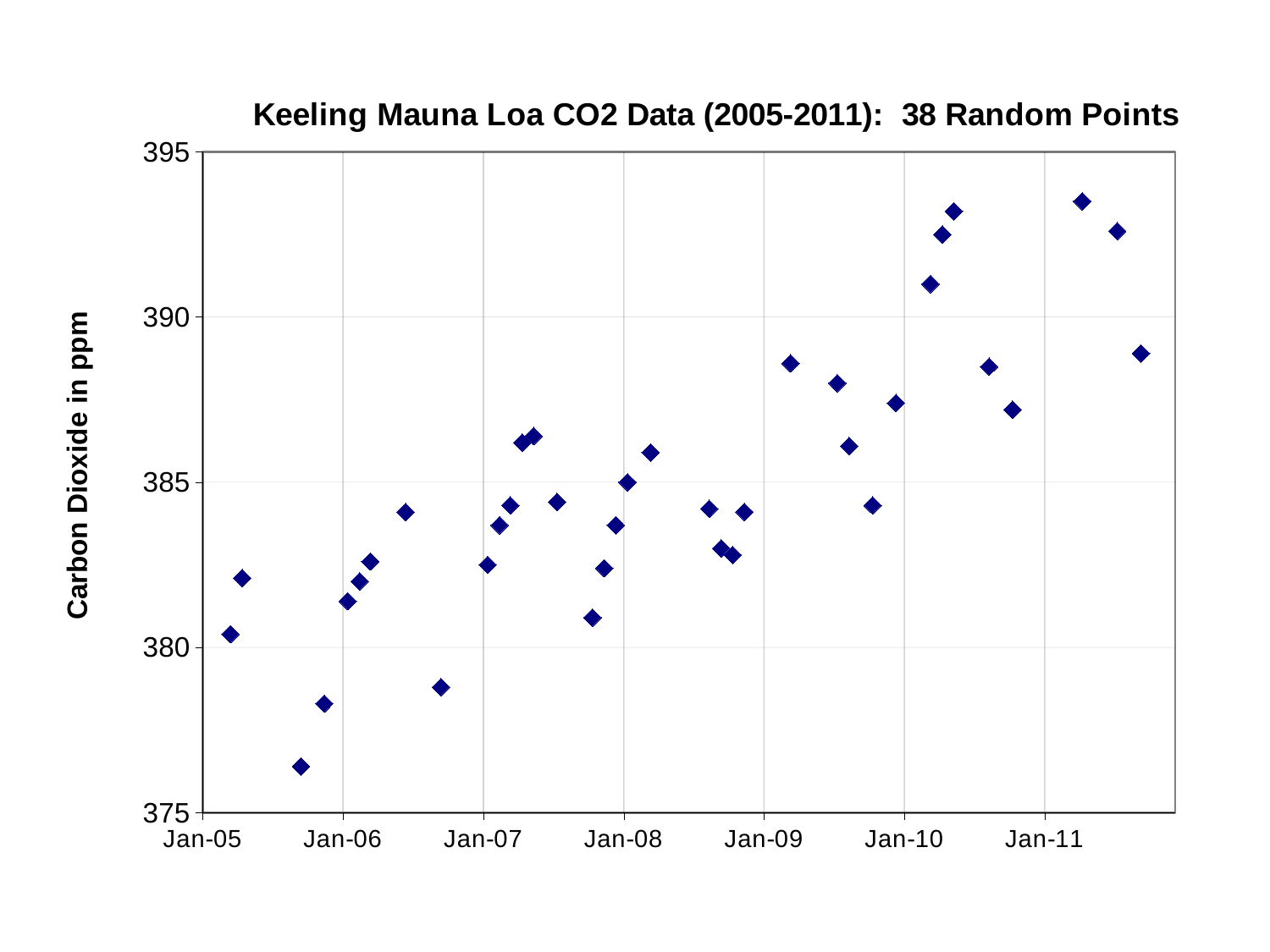
Do the CO2 values generally rise or fall from Jan-05 to Jan-11? Rise Is the first data point (at Jan-05) greater or less than 385 ppm? less Is the last data point (after Jan-11) greater or less than 385 ppm? greater How many data points does the chart contain, according to its title? 38 Which is larger: the first data point near Jan-05 or the last data point after Jan-11? The last data point after Jan-11 What is the label of the vertical axis? Carbon Dioxide in ppm What is the maximum value shown on the vertical axis? 395 What kind of chart is shown on the slide? Scatter plot Is the lowest plotted CO2 value greater or less than 380 ppm? less In which calendar year does the lowest CO2 value on the chart occur? 2005 What is the title of the chart? Keeling Mauna Loa CO2 Data (2005-2011): 38 Random Points